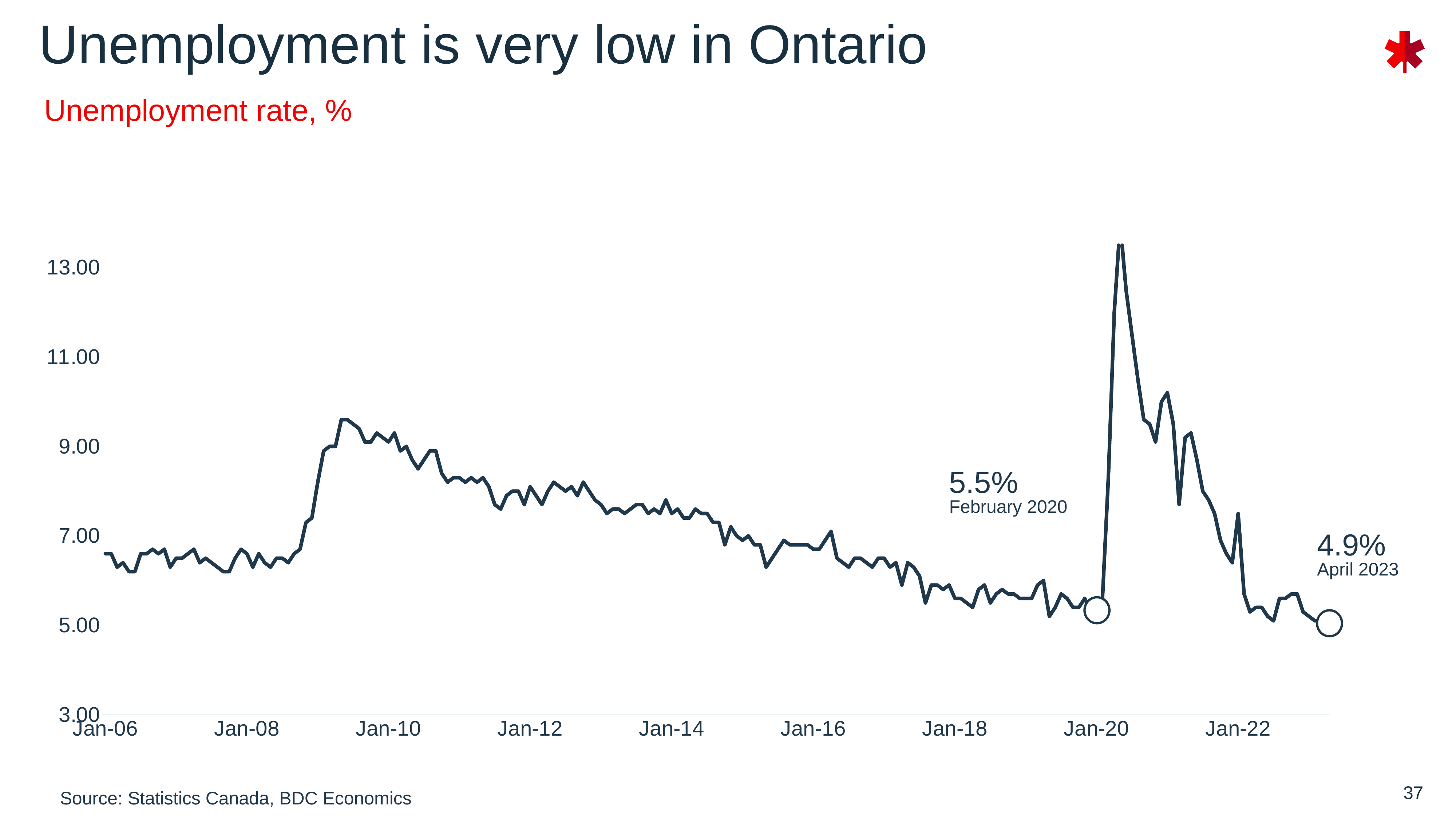
What was the unemployment rate in Ontario in February 2020, as labelled on the chart? 5.5% Did the unemployment rate generally rise or fall between Jan-10 and Jan-20? fall What is the source cited for the chart data? Statistics Canada, BDC Economics What kind of chart is shown on the slide? Line chart Is the unemployment rate at Jan-06 greater or less than 7.00? less By how many percentage points did the labelled unemployment rate fall from February 2020 to April 2023? 0.6 In which year does the chart show the highest unemployment rate? 2020 Is the peak unemployment rate reached in 2020 greater or less than 13.00? greater Which labelled point is higher: February 2020 or April 2023? February 2020 What was the unemployment rate in Ontario in April 2023, as labelled on the chart? 4.9% What is the subtitle describing the plotted measure? Unemployment rate, %